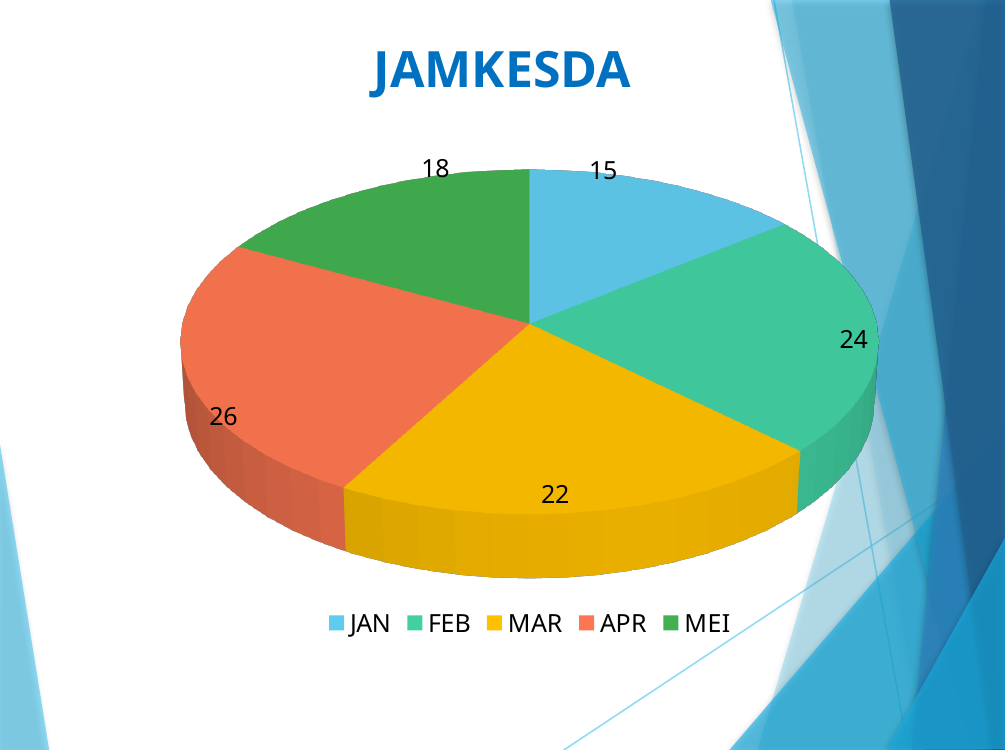
What is the difference between the values for APR and JAN in the JAMKESDA chart? 11 Which category has the smallest slice in the JAMKESDA pie chart? JAN What is the difference between the values for FEB and MAR in the JAMKESDA chart? 2 What is the value for MEI in the JAMKESDA pie chart? 18 How many categories are shown in the JAMKESDA pie chart? 5 What is the value for APR in the JAMKESDA pie chart? 26 What is the value for JAN in the JAMKESDA pie chart? 15 What kind of chart is shown on the slide? Pie chart Which category has the largest slice in the JAMKESDA pie chart? APR What is the title of the chart on the slide? JAMKESDA Which is larger in the JAMKESDA chart, FEB or MEI? FEB What is the total of all the slice values in the JAMKESDA pie chart? 105